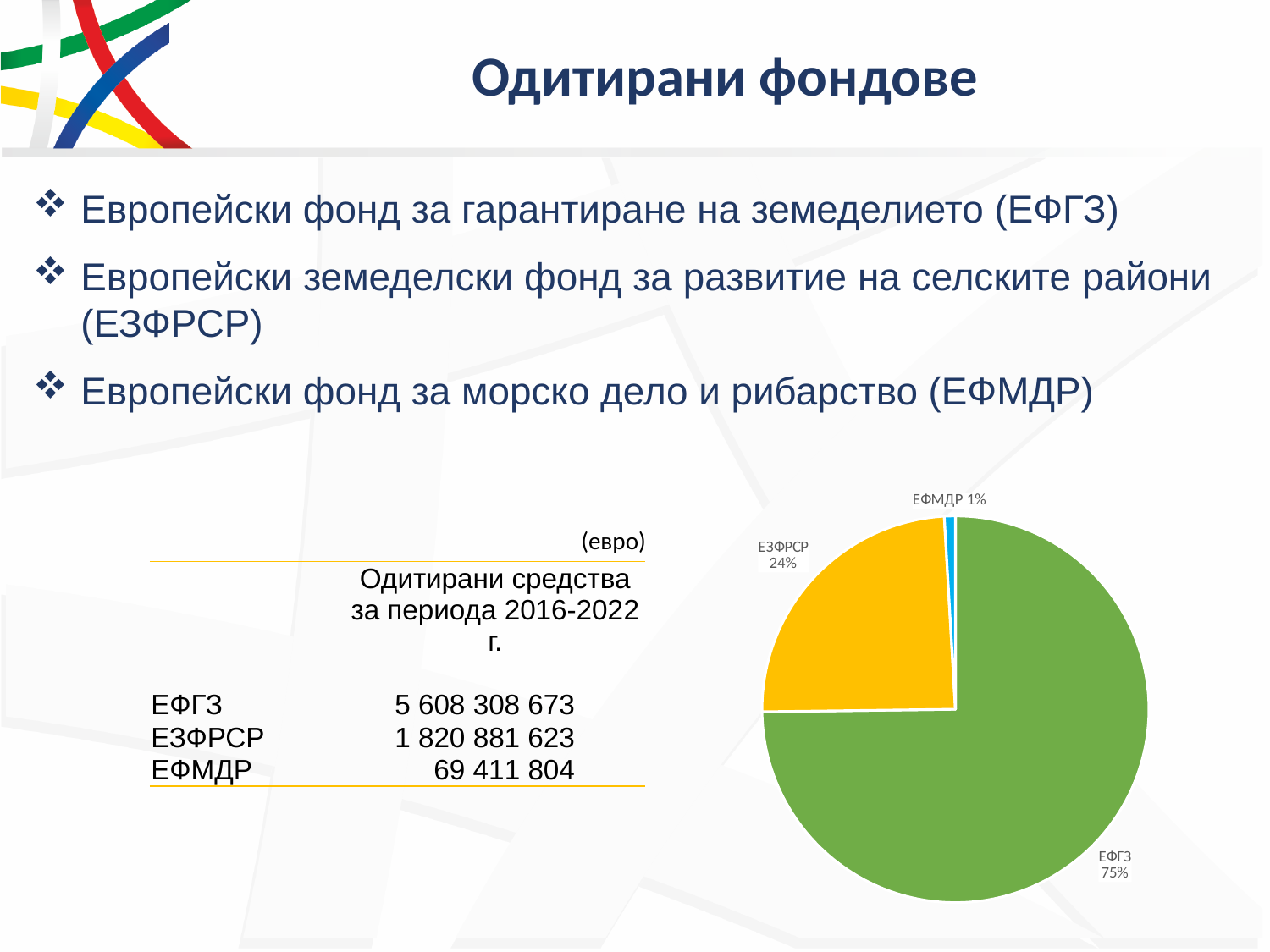
What is the difference in percentage points between the ЕЗФРСР and ЕФМДР slices? 23 What kind of chart is shown on the slide? pie chart How many slices does the pie chart have? 3 What share of the pie does ЕЗФРСР represent? 24% What colour is the ЕЗФРСР slice in the pie chart? yellow What share of the pie does ЕФМДР represent? 1% What is the difference in percentage points between the ЕФГЗ and ЕЗФРСР slices? 51 What share of the pie does ЕФГЗ represent? 75% Which slice is larger in the pie chart, ЕЗФРСР or ЕФМДР? ЕЗФРСР What colour is the ЕФГЗ slice in the pie chart? green Which fund has the smallest slice in the pie chart? ЕФМДР Which fund has the largest slice in the pie chart? ЕФГЗ